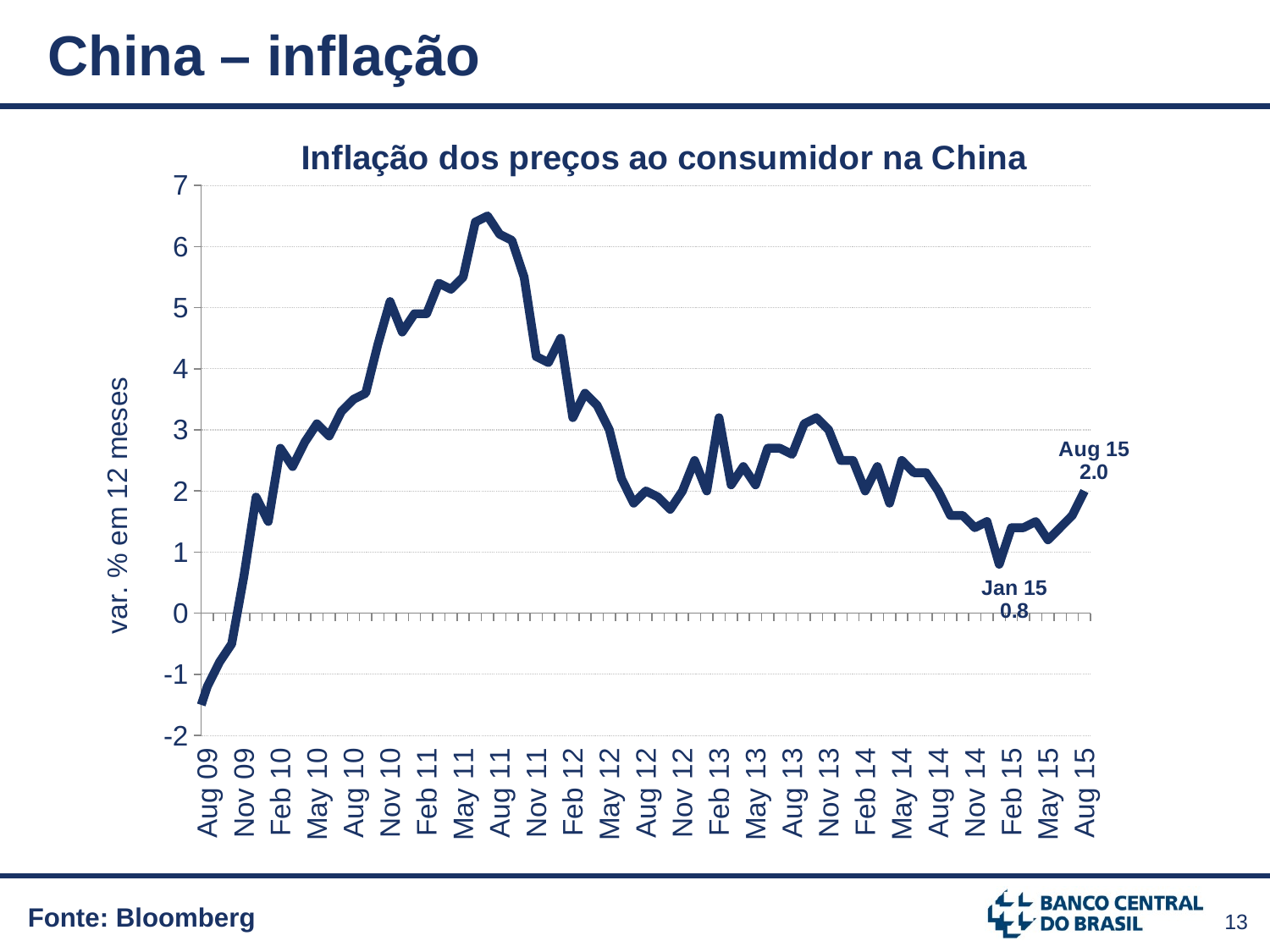
Is the highest point on the line greater or less than 6? greater At which x-axis label does the line reach its lowest value? Aug 09 What kind of chart is shown on the slide? line chart Is the value for Nov 10 greater or less than 4? greater What is the value labelled for Jan 15? 0.8 What is the title of the chart? Inflação dos preços ao consumidor na China Which is larger, the labelled value for Jan 15 or for Aug 15? Aug 15 What is the difference between the labelled values for Aug 15 and Jan 15? 1.2 What is the value labelled for Aug 15? 2.0 Is the value for Aug 12 greater or less than 3? less Does the line rise or fall between Jan 15 and Aug 15? rise